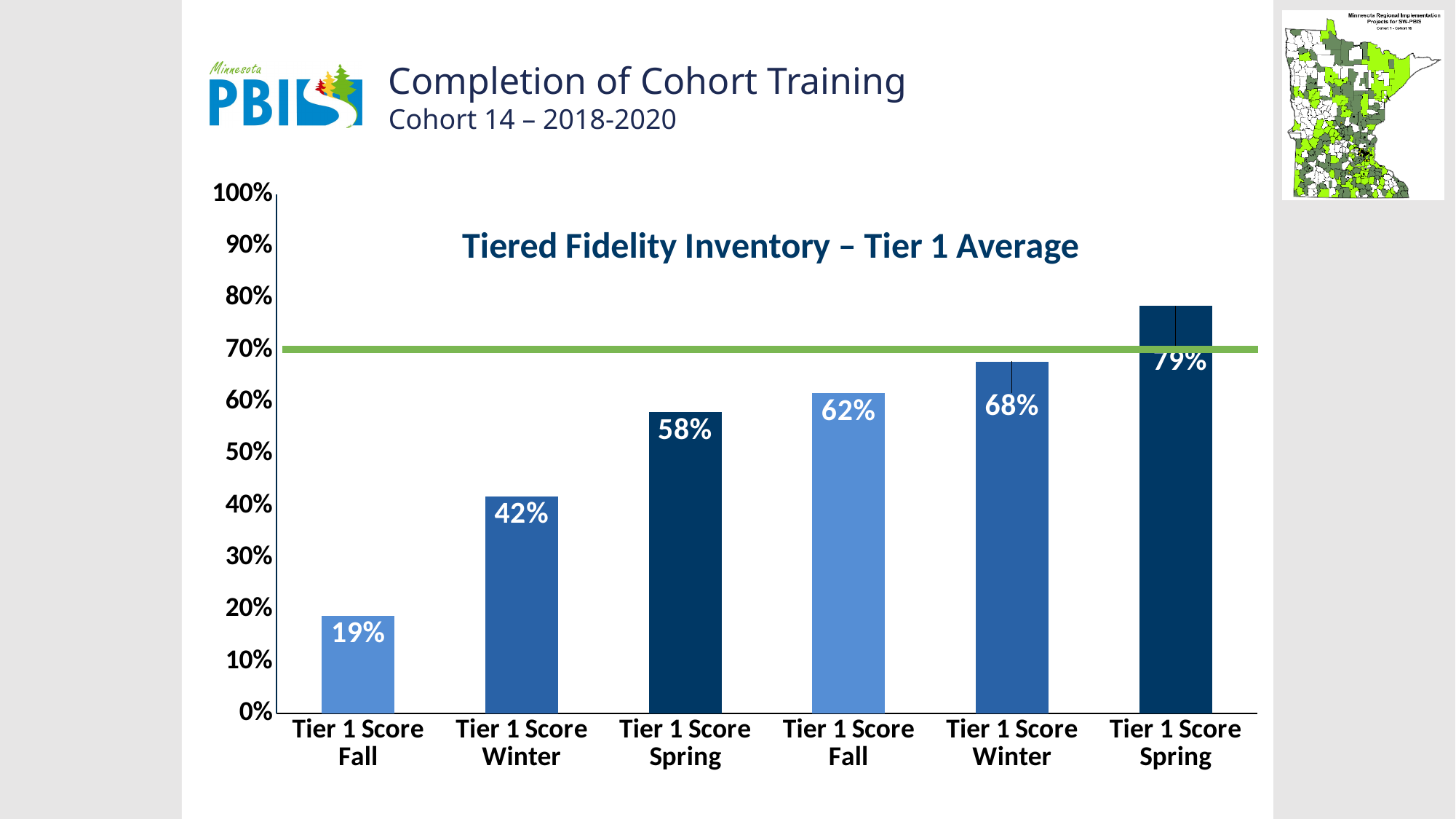
Do the bar values rise or fall from left to right across the chart? rise How many bars are plotted in the chart? 6 What is the value of the first Tier 1 Score Winter bar (second bar from the left)? 42% What is the title of the chart? Tiered Fidelity Inventory – Tier 1 Average What is the value of the second Tier 1 Score Fall bar (fourth bar from the left)? 62% Which bar has the lowest value? Tier 1 Score Fall (leftmost bar) Which bar has the highest value? Tier 1 Score Spring (rightmost bar) What is the value of the first (leftmost) Tier 1 Score Fall bar? 19% What is the value of the rightmost Tier 1 Score Spring bar? 79% What is the difference between the rightmost Tier 1 Score Spring bar (79%) and the leftmost Tier 1 Score Fall bar (19%)? 60% What type of chart is shown on the slide? bar chart What is the value of the first Tier 1 Score Spring bar (third bar from the left)? 58%